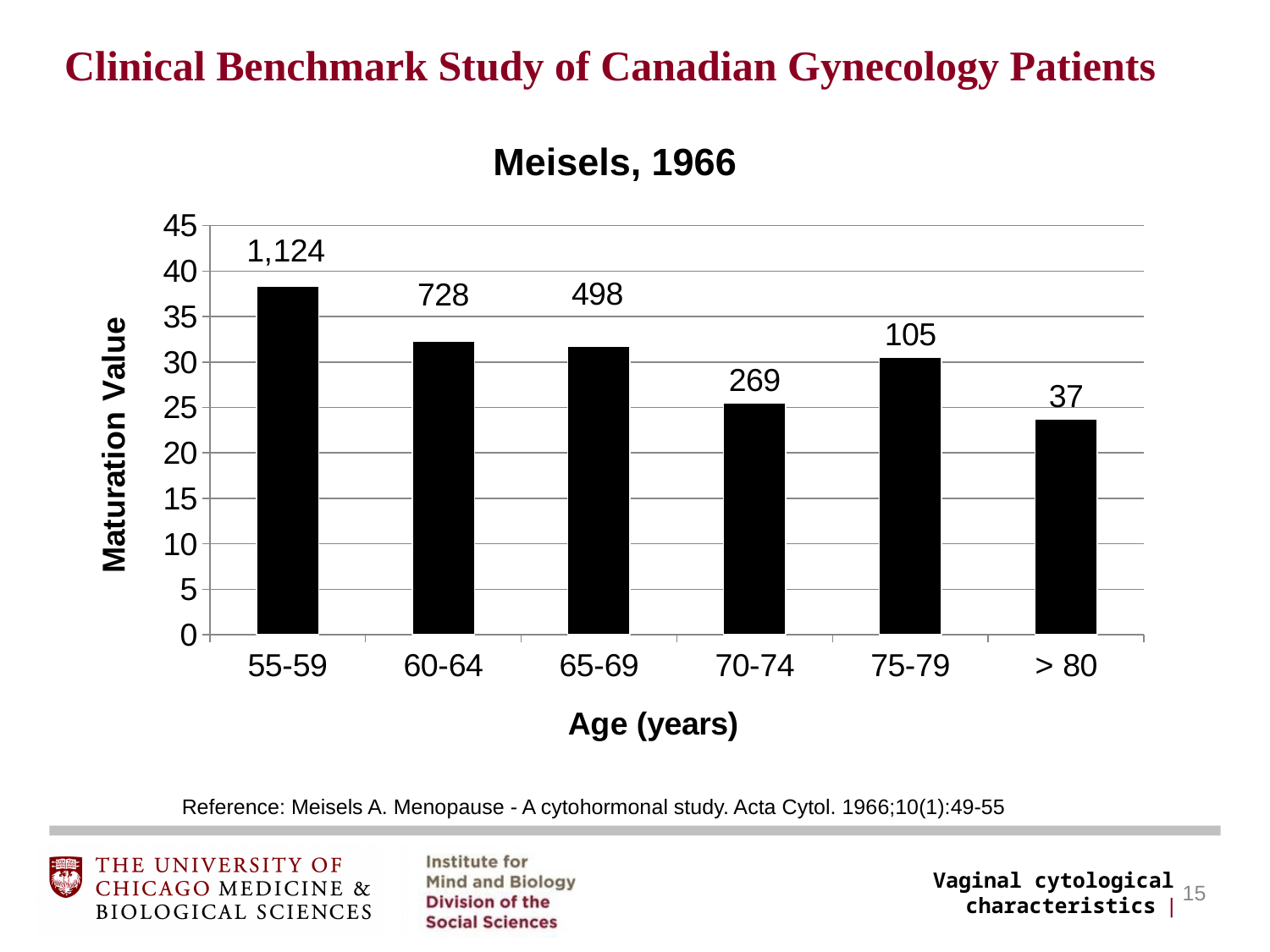
What number is printed above the bar for the 55-59 age group? 1,124 Which age group has a higher maturation value, 70-74 or 75-79? 75-79 What is the label on the vertical axis of the chart? Maturation Value What kind of chart is shown on the slide? bar chart How many age groups are shown on the x axis of the chart? 6 What is the title of the chart? Meisels, 1966 What number is printed above the bar for the > 80 age group? 37 Which age group has the shortest bar in the chart? > 80 What number is printed above the bar for the 70-74 age group? 269 Is the maturation value for the 55-59 age group greater or less than 35? greater Is the maturation value for the > 80 age group greater or less than 25? less Which age group has the tallest bar in the chart? 55-59